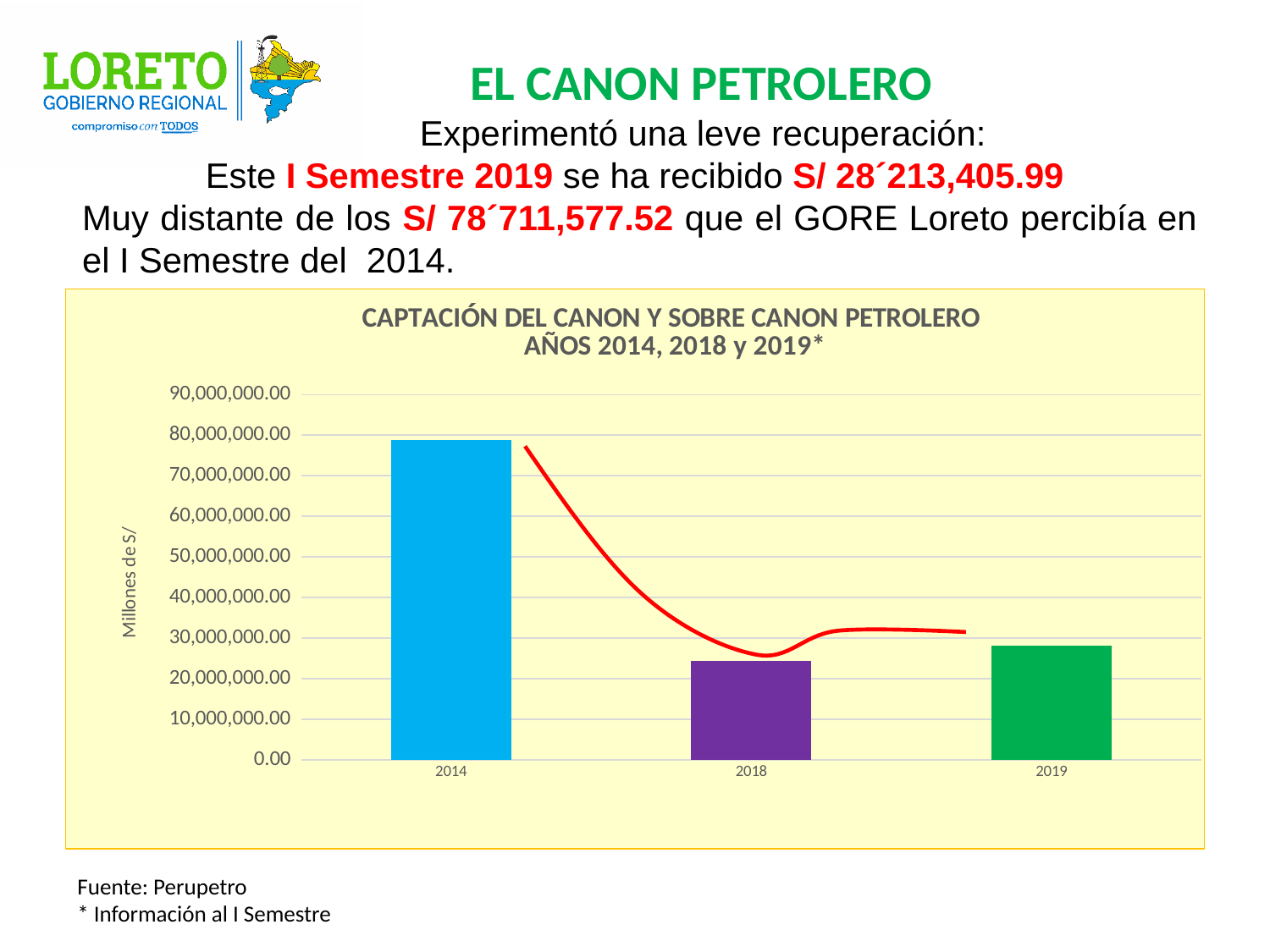
According to the slide, how much did GORE Loreto receive in the I Semestre of 2014? S/ 78´711,577.52 According to the slide, how much was received in the I Semestre 2019? S/ 28´213,405.99 Which year has the lowest bar in the chart? 2018 What kind of chart is shown on the slide? bar chart How many years (categories) are plotted on the x axis of the chart? 3 Is the value for 2014 greater or less than 70,000,000.00? greater Which year has the highest bar in the chart? 2014 Does the value fall or rise from 2014 to 2018? fall Is the value for 2018 greater or less than 30,000,000.00? less Which bar is taller, 2018 or 2019? 2019 Is the value for 2019 greater or less than 20,000,000.00? greater What is the label on the vertical axis of the chart? Millones de S/